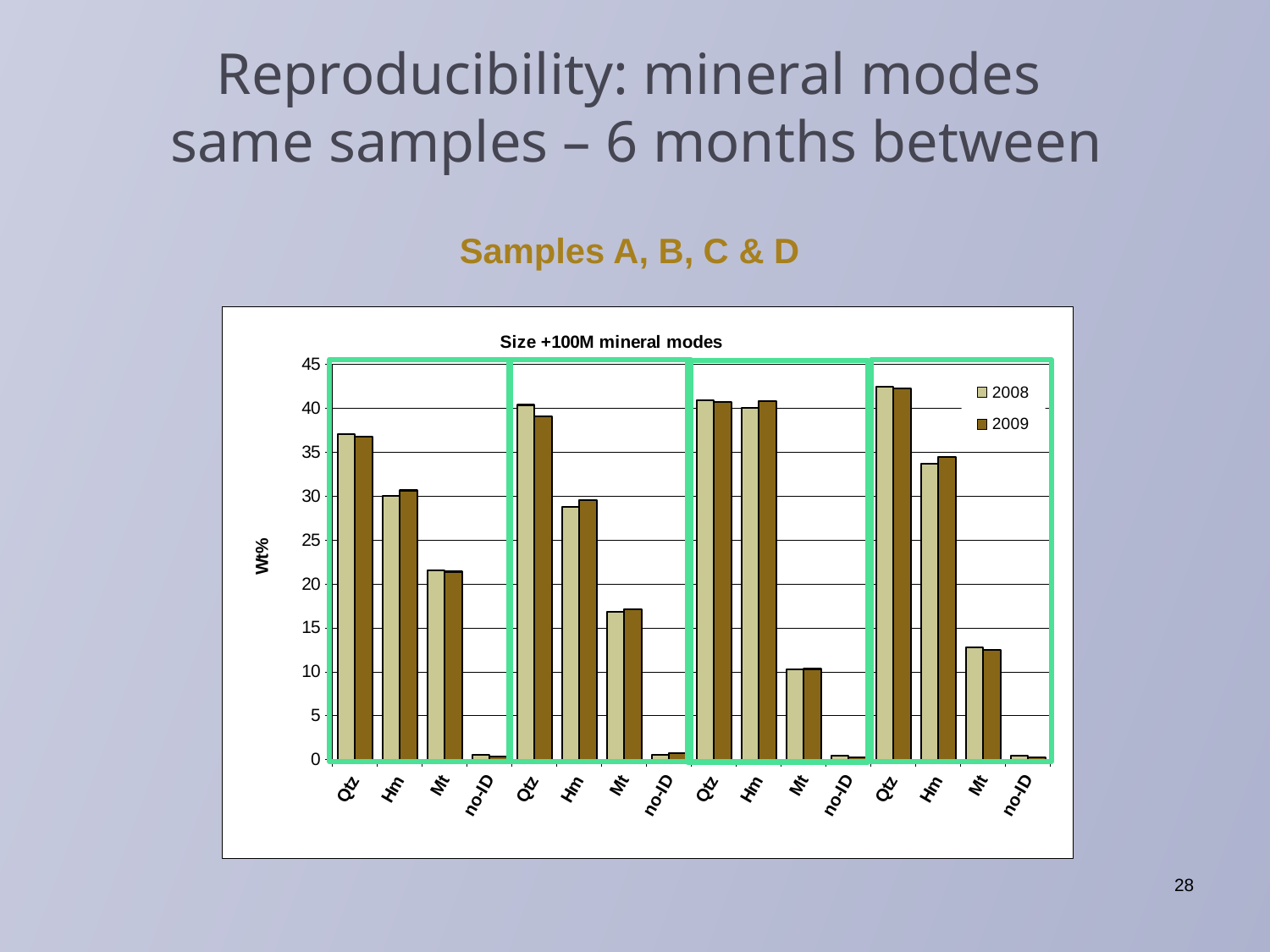
Is the 2008 value for Qtz in the first (leftmost) group greater or less than 35? greater In the first (leftmost) group, which is larger for 2008: Qtz or Hm? Qtz What kind of chart is shown on the slide? bar chart Within each group, do the values rise or fall going from Qtz to no-ID? fall Is the 2009 value for Mt in the second group greater or less than 15? greater What is the title of the chart? Size +100M mineral modes What are the two series named in the legend? 2008 and 2009 How many categories are shown along the x axis? 16 Which mineral has the tallest bars in the fourth (rightmost) group? Qtz Is the 2008 value for Hm in the fourth (rightmost) group greater or less than 35? less How many series does the legend list? 2